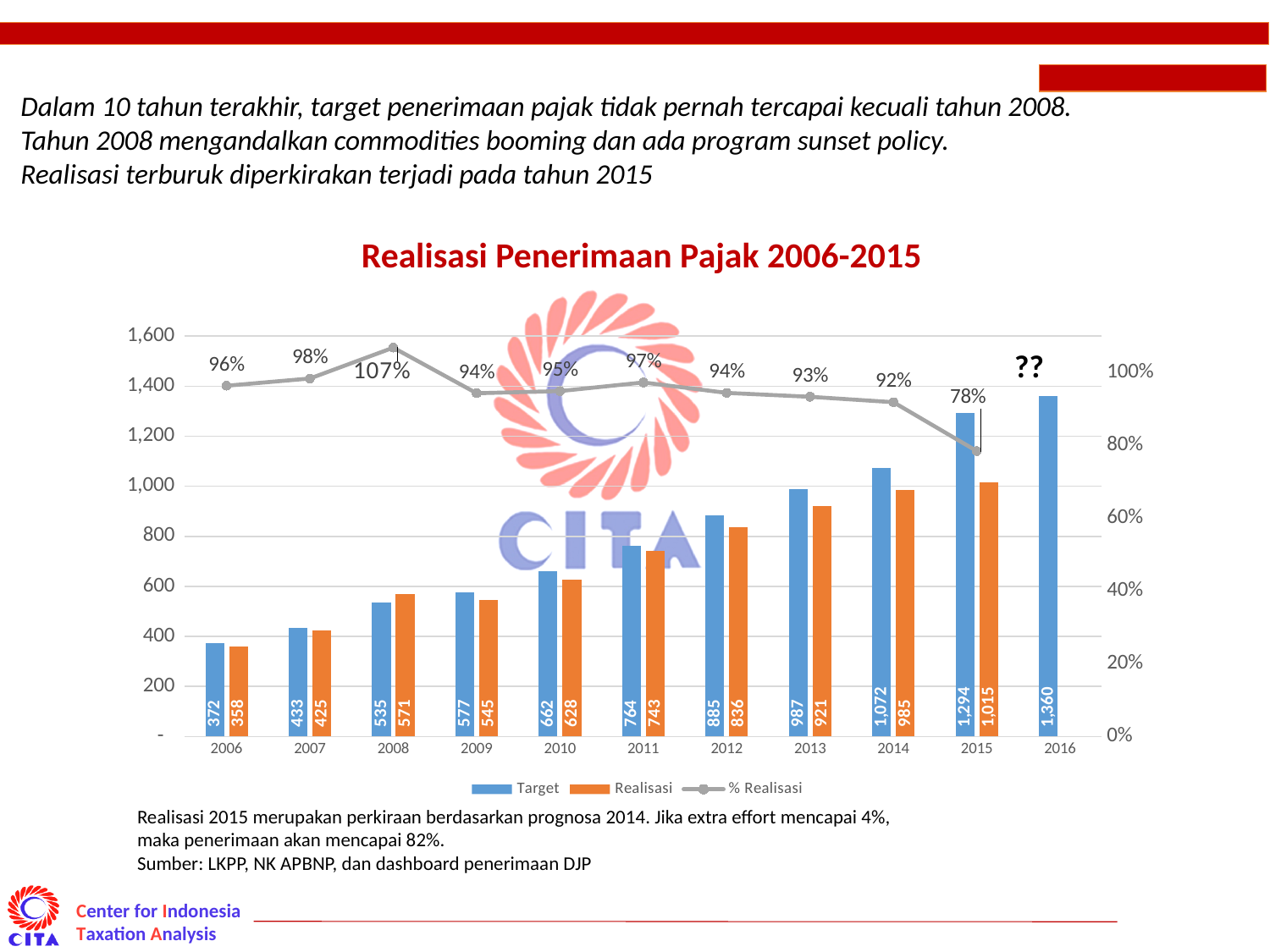
What is the title of the chart? Realisasi Penerimaan Pajak 2006-2015 What is the Target value for 2015? 1,294 In which year is the % Realisasi line lowest? 2015 Do the Target values rise or fall from 2006 to 2016? Rise In which year is the % Realisasi line highest? 2008 How many series does the legend list? 3 What kind of chart is this? Combined bar and line chart What is the Realisasi value for 2008? 571 What is the difference between the Target and Realisasi values for 2015? 279 Which is larger in 2008, the Target or the Realisasi value? Realisasi What is the % Realisasi value for 2015? 78% What is the Target value for 2016? 1,360